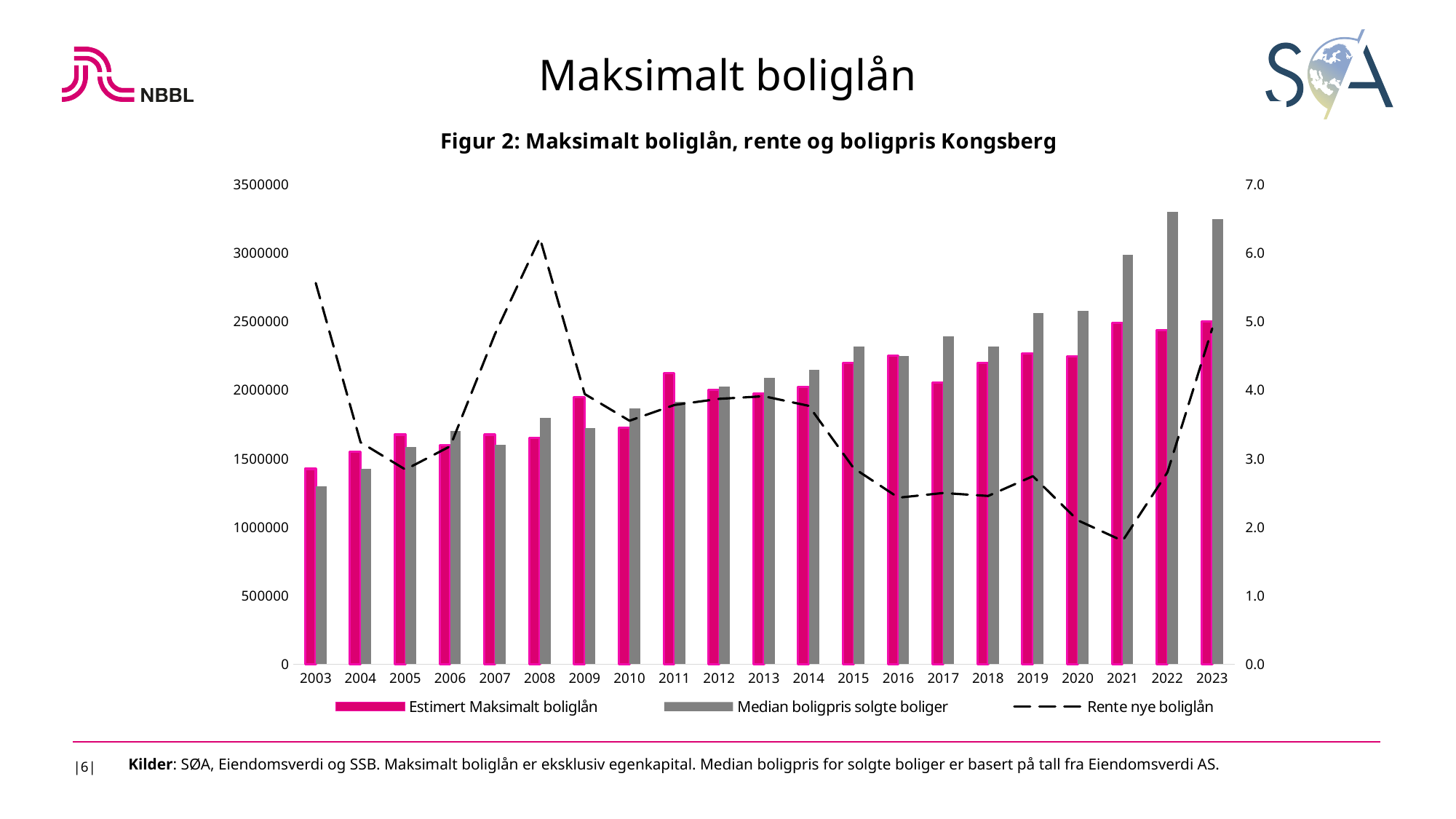
In which year does the Rente nye boliglån line reach its highest point? 2008 In which year does the Rente nye boliglån line reach its lowest point? 2021 In 2022, which is larger: Estimert Maksimalt boliglån or Median boligpris solgte boliger? Median boligpris solgte boliger In which year is the Median boligpris solgte boliger lowest? 2003 Is the Estimert Maksimalt boliglån for 2011 greater or less than 2000000? greater How many series does the legend of Figur 2 list? 3 Does the Median boligpris solgte boliger generally rise or fall from 2003 to 2023? rise Is the Median boligpris solgte boliger for 2022 greater or less than 3000000? greater In which year is the Estimert Maksimalt boliglån lowest? 2003 Is the Rente nye boliglån for 2021 greater or less than 2.0? less What kind of chart is shown in Figur 2? A bar chart combined with a dashed line How many years are shown on the x axis of Figur 2? 21